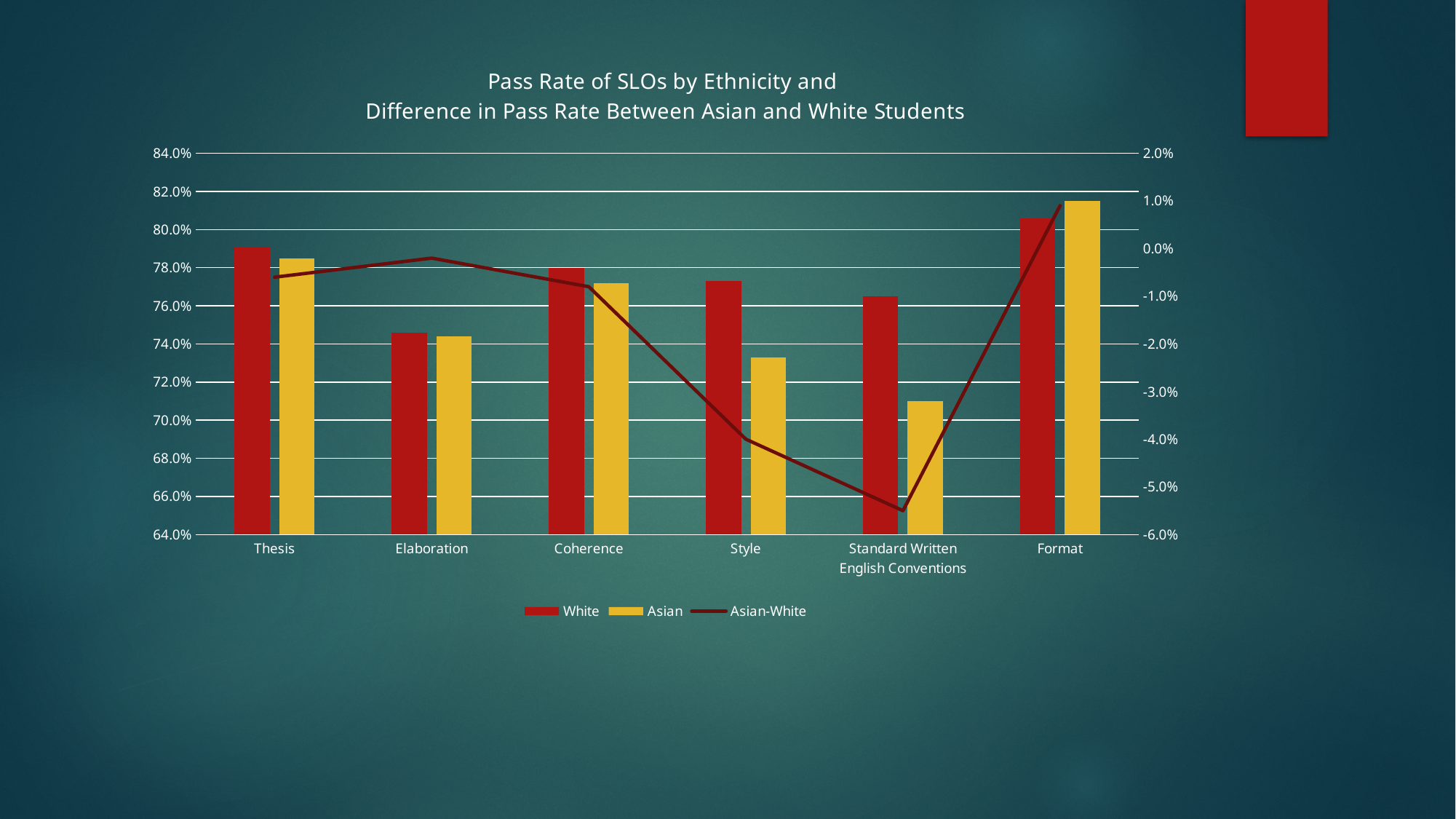
At which SLO does the Asian-White difference line reach its lowest point? Standard Written English Conventions What kind of chart is shown on the slide? A combined bar and line chart Is the Asian pass rate for Style greater or less than 74.0%? less How many series does the legend list? 3 For Style, which group has the higher pass rate, White or Asian? White Which SLO has the highest pass rate for White students? Format Which SLO has the lowest pass rate for Asian students? Standard Written English Conventions Is the White pass rate for Thesis greater or less than 78.0%? greater How many SLO categories are shown on the x axis? 6 Is the Asian-White difference for Format greater or less than 0.0%? greater Which SLO has the lowest pass rate for White students? Elaboration Which SLO has the highest pass rate for Asian students? Format